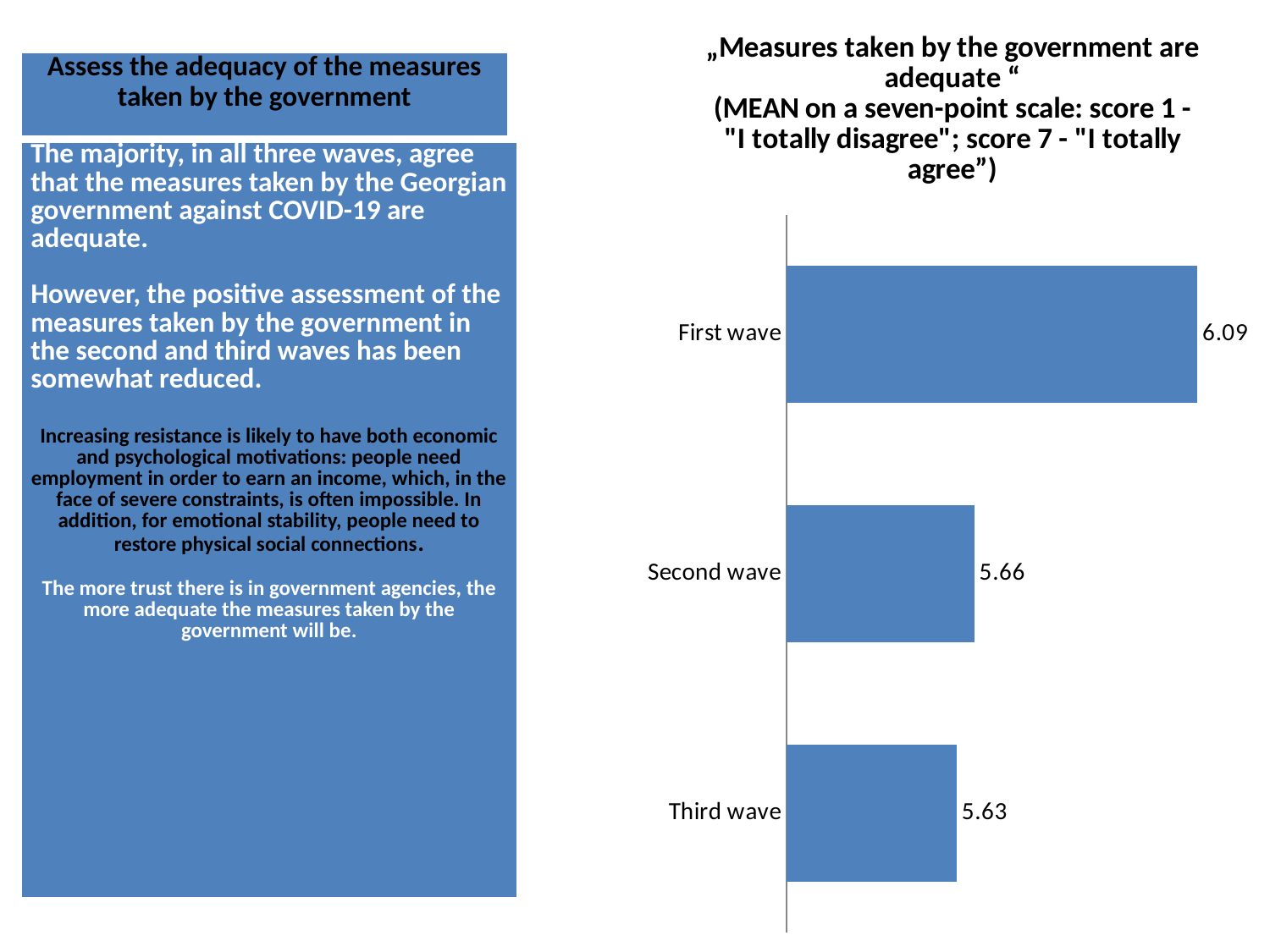
Do the mean scores rise or fall from the First wave to the Third wave? Fall Which wave has the lowest mean score? Third wave What is the mean score for the First wave? 6.09 What is the difference between the mean scores for the Second wave and the Third wave? 0.03 What is the mean score for the Third wave? 5.63 Which has a larger mean score, the First wave or the Third wave? First wave Which wave has the highest mean score? First wave How many waves are shown in the chart? 3 What scale is used for the mean scores in the chart, according to its title? A seven-point scale What is the mean score for the Second wave? 5.66 What is the difference between the mean scores for the First wave and the Second wave? 0.43 What kind of chart is shown on the slide? Bar chart